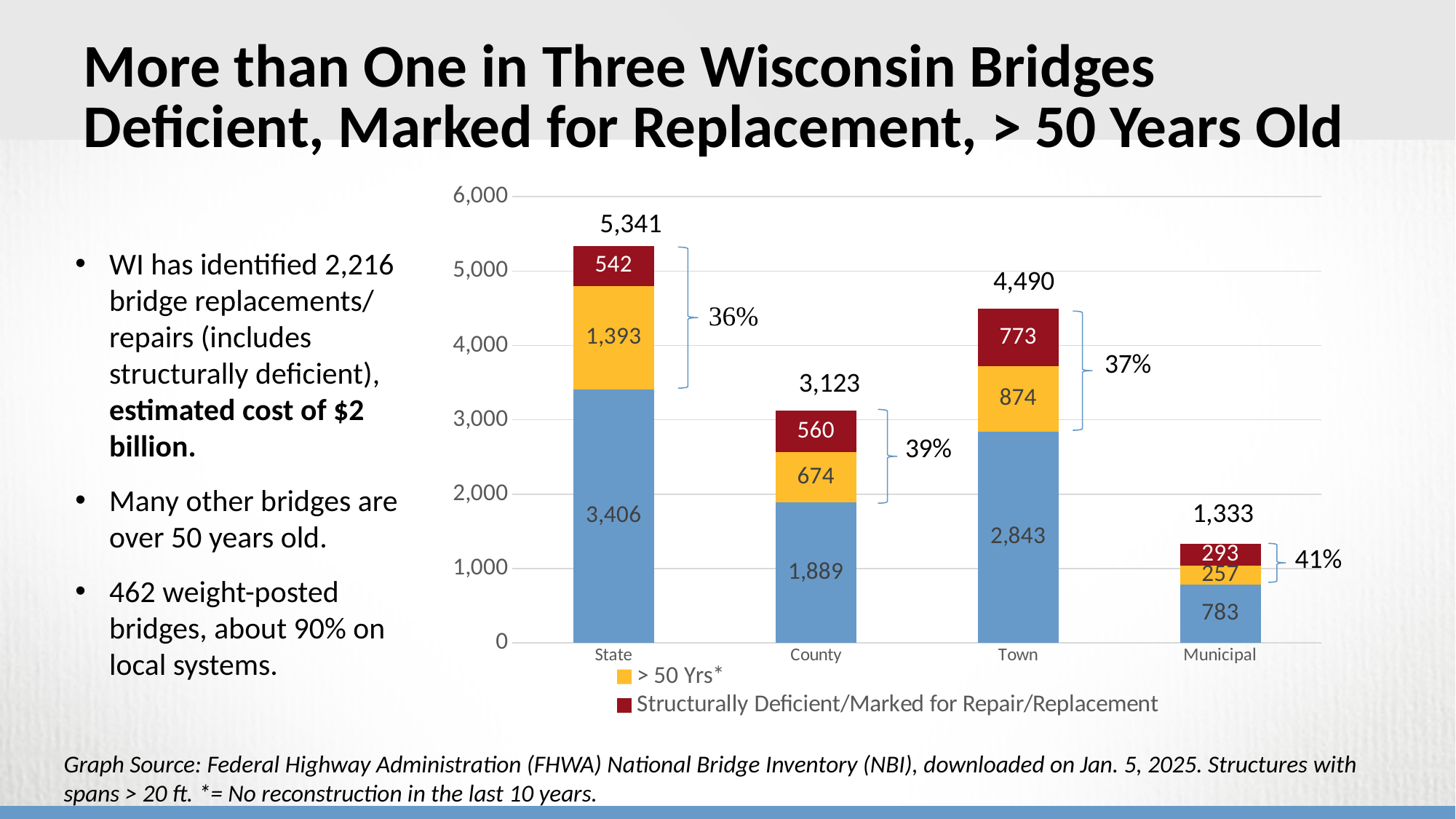
Which has the larger "Structurally Deficient/Marked for Repair/Replacement" value, County or Town? Town Which category has the lowest total bar? Municipal What is the "> 50 Yrs*" value for County? 674 What is the difference between the "> 50 Yrs*" values for Town and Municipal? 617 What percentage is shown next to the bracket for the Municipal bar? 41% What is the total shown above the Municipal bar? 1,333 Which category has the highest total bar? State How many series does the legend list? 2 What is the total shown above the State bar? 5,341 What is the "Structurally Deficient/Marked for Repair/Replacement" value for Town? 773 What is the difference between the State total (5,341) and the Town total (4,490)? 851 How many categories are shown on the x axis? 4